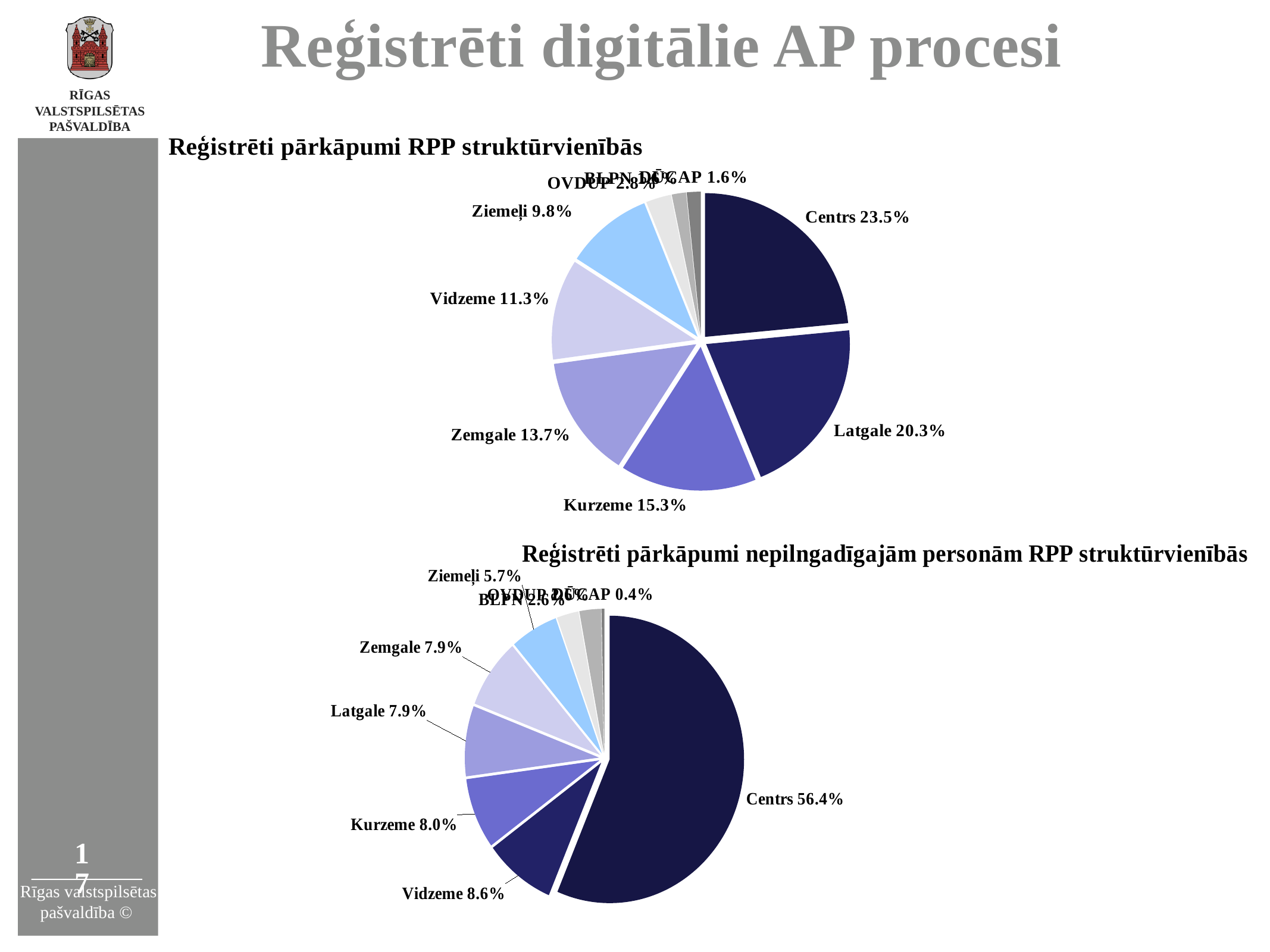
In the top chart 'Reģistrēti pārkāpumi RPP struktūrvienībās', which category has the largest share? Centrs In the top chart 'Reģistrēti pārkāpumi RPP struktūrvienībās', what is the value for Ziemeļi? 9.8% What is the title of the bottom chart on the slide? Reģistrēti pārkāpumi nepilngadīgajām personām RPP struktūrvienībās In the bottom chart 'Reģistrēti pārkāpumi nepilngadīgajām personām RPP struktūrvienībās', what is the value for Vidzeme? 8.6% In the bottom chart 'Reģistrēti pārkāpumi nepilngadīgajām personām RPP struktūrvienībās', which category has the largest share? Centrs In the bottom chart 'Reģistrēti pārkāpumi nepilngadīgajām personām RPP struktūrvienībās', what is the difference between Kurzeme and Ziemeļi? 2.3% In the top chart 'Reģistrēti pārkāpumi RPP struktūrvienībās', what is the difference between Centrs and Latgale? 3.2% What type of chart is used for 'Reģistrēti pārkāpumi RPP struktūrvienībās'? Pie chart In the top chart 'Reģistrēti pārkāpumi RPP struktūrvienībās', which is larger, Zemgale or Vidzeme? Zemgale In the top chart 'Reģistrēti pārkāpumi RPP struktūrvienībās', what is the value for Kurzeme? 15.3% In the top chart 'Reģistrēti pārkāpumi RPP struktūrvienībās', what share does Centrs have? 23.5% In the bottom chart 'Reģistrēti pārkāpumi nepilngadīgajām personām RPP struktūrvienībās', what share does Centrs have? 56.4%